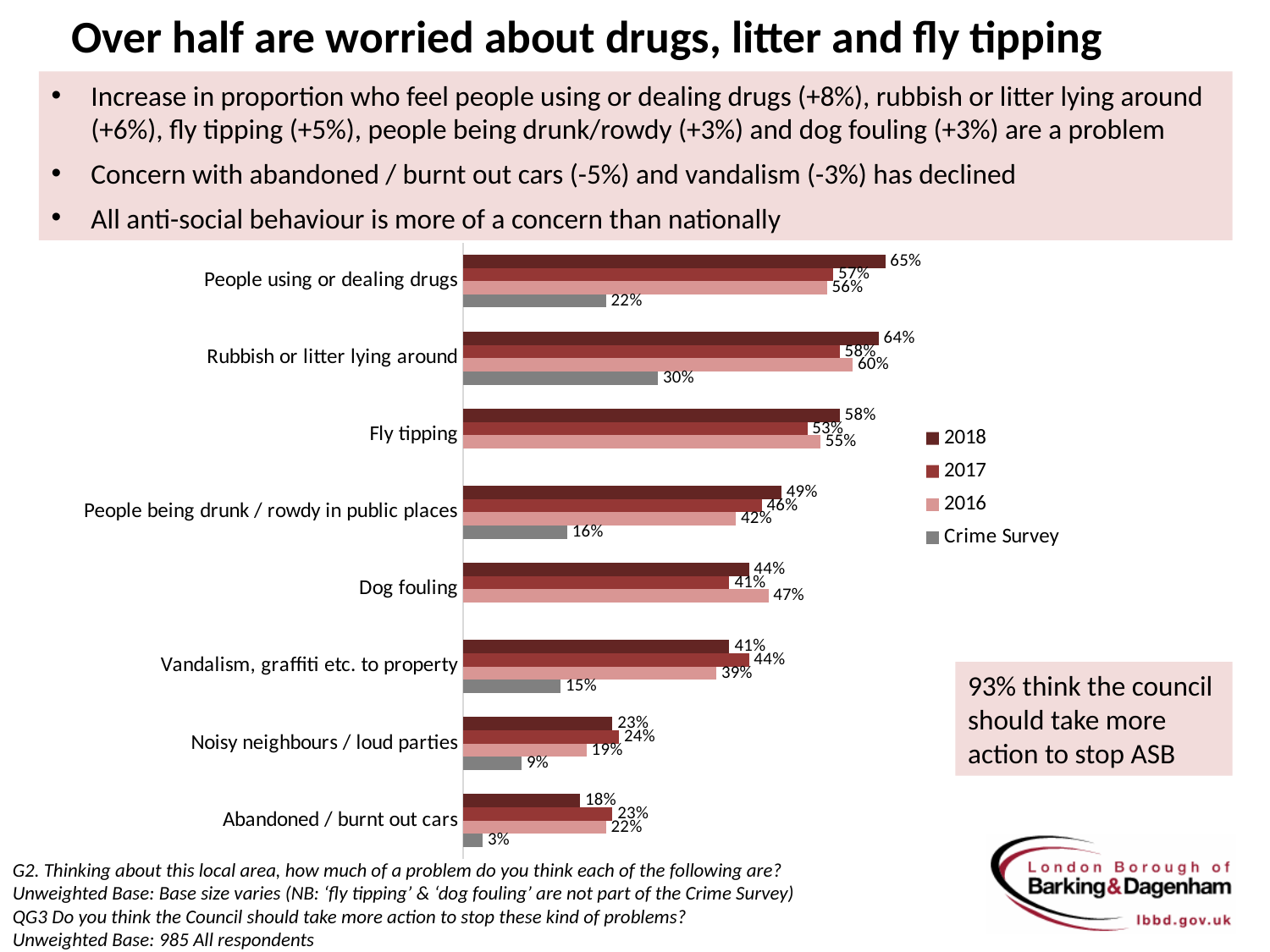
Which series is shown in grey in the legend? Crime Survey How many series does the legend list? 4 What is the 2017 value for Abandoned / burnt out cars? 23% What is the 2018 value for People using or dealing drugs? 65% What is the difference between the 2018 and 2017 values for People using or dealing drugs? 8% Which is larger for Vandalism, graffiti etc. to property: the 2018 value or the 2017 value? 2017 What is the Crime Survey value for Rubbish or litter lying around? 30% What is the 2016 value for Dog fouling? 47% Which category has the lowest Crime Survey value? Abandoned / burnt out cars Which category has the highest 2018 value? People using or dealing drugs How many categories are shown on the chart? 8 What kind of chart is shown on the slide? Bar chart